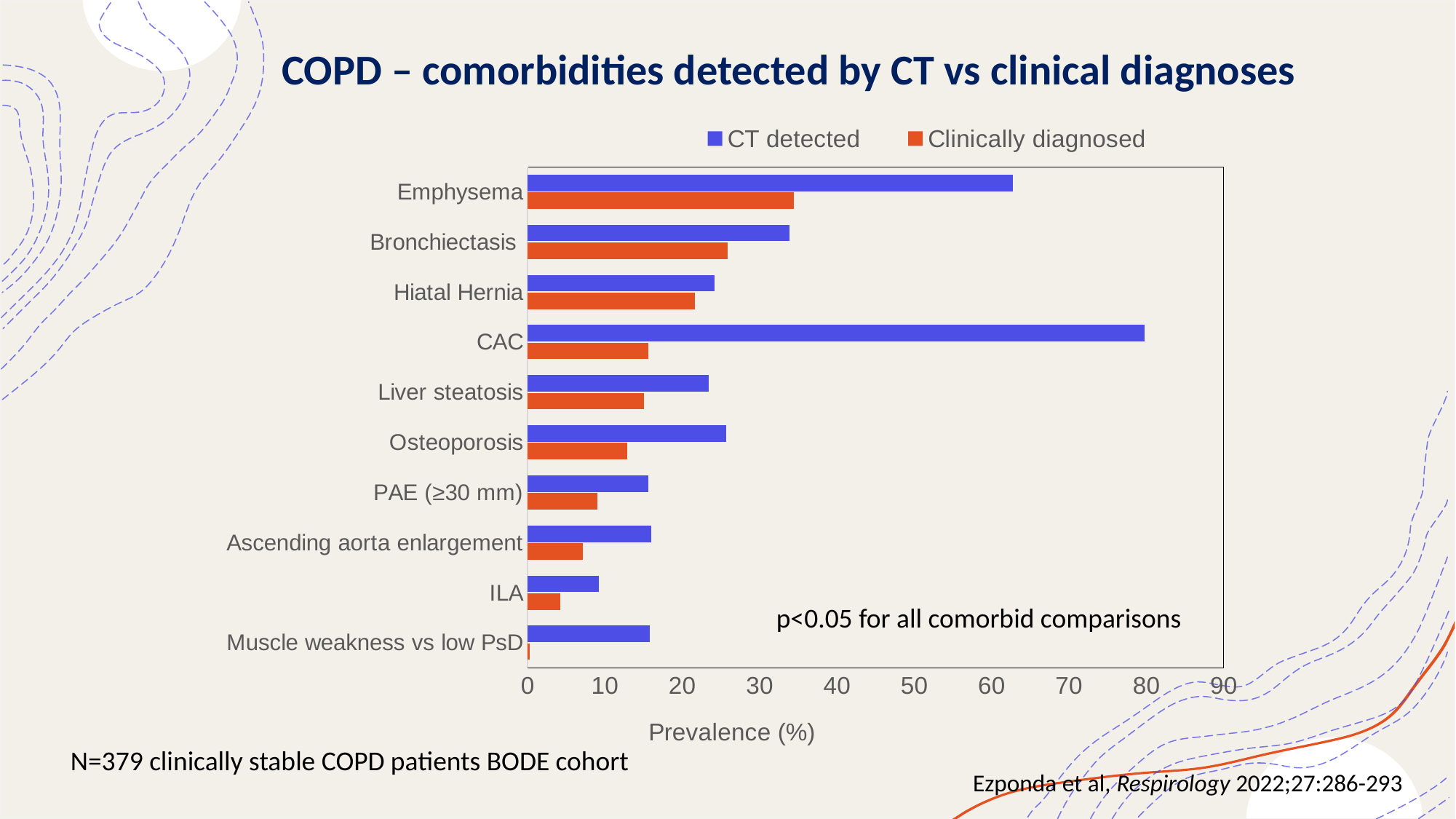
Which comorbidity has the lowest CT detected prevalence? ILA Is the CT detected prevalence for CAC greater or less than 70? greater Is the clinically diagnosed prevalence for Emphysema greater or less than 30? greater How many series does the legend list? 2 What kind of chart is shown on the slide? bar chart For CAC, which is larger: the CT detected prevalence or the clinically diagnosed prevalence? CT detected Which comorbidity has the lowest clinically diagnosed prevalence? Muscle weakness vs low PsD What is the label of the x axis? Prevalence (%) How many comorbidity categories are plotted on the chart? 10 Which comorbidity has the highest clinically diagnosed prevalence? Emphysema Is the clinically diagnosed prevalence for ILA greater or less than 10? less Which comorbidity has the highest CT detected prevalence? CAC